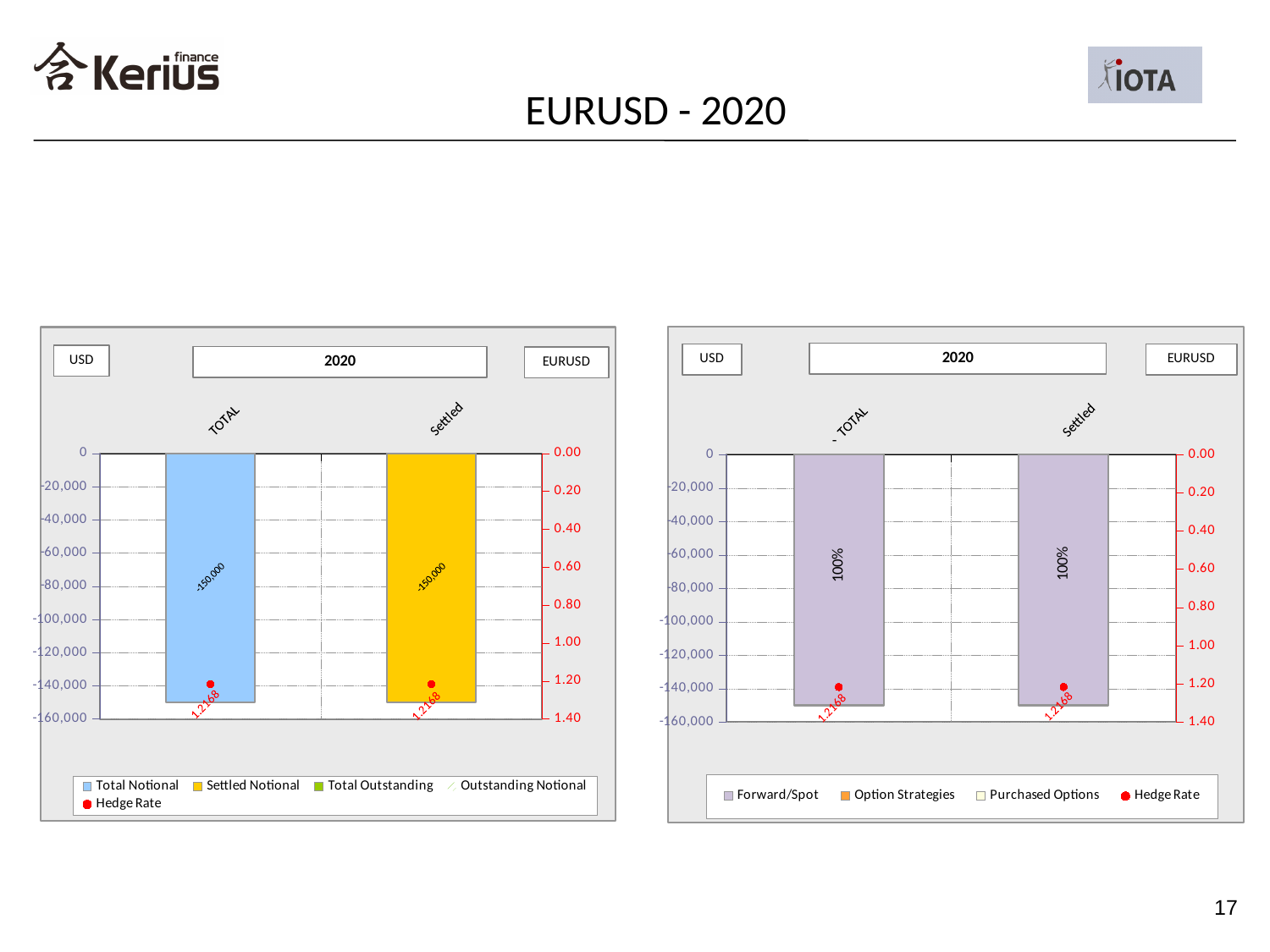
On the right chart, which legend entry is shown with a red circle marker? Hedge Rate On the right chart, what is the Hedge Rate value shown for TOTAL? 1.2168 On the right chart, what percentage is labelled on the Forward/Spot bar for Settled? 100% On the left chart, what is the data label on the TOTAL bar? -150,000 On the left chart, what is the difference between the TOTAL bar value and the Settled bar value? 0 What kind of chart is the right chart? Bar chart with a line/marker series How many series does the legend of the right chart list? 4 How many categories are shown on the x axis of the left chart? 2 On the left chart, what is the Hedge Rate value shown for TOTAL? 1.2168 On the left chart, what is the data label on the Settled bar? -150,000 How many series does the legend of the left chart list? 5 What year is shown in the title box of the left chart? 2020